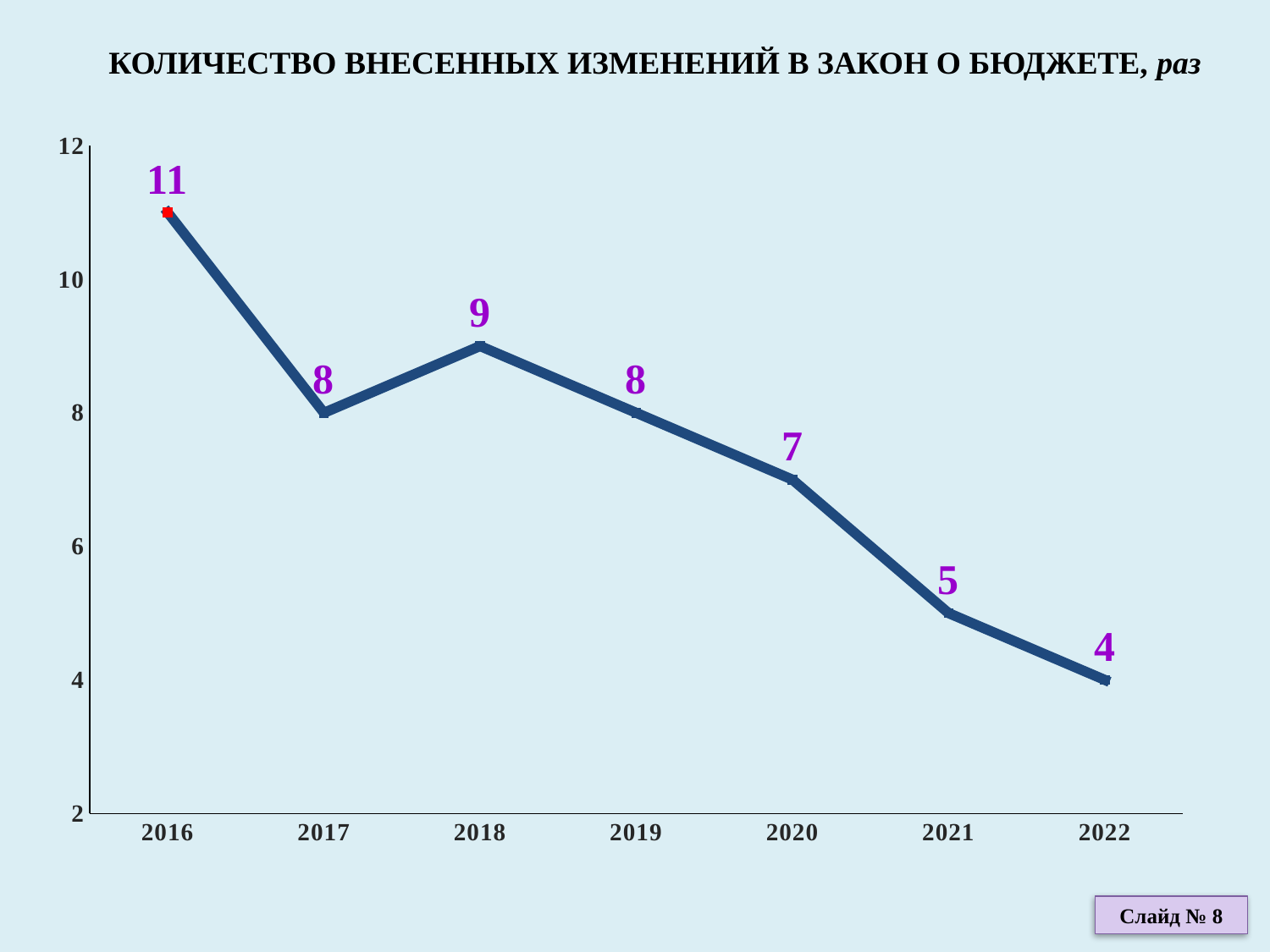
What is the value for 2021? 5 What is the value for 2022? 4 Do the values generally rise or fall from 2016 to 2022? fall What kind of chart is shown on the slide? line chart Which year has the highest value? 2016 What is the value for 2016? 11 What is the value for 2018? 9 Which is larger, the value for 2018 or the value for 2020? 2018 What is the difference between the values for 2016 and 2022? 7 What is the title of the chart? КОЛИЧЕСТВО ВНЕСЕННЫХ ИЗМЕНЕНИЙ В ЗАКОН О БЮДЖЕТЕ, раз How many years are plotted on the chart? 7 Which year has the lowest value? 2022